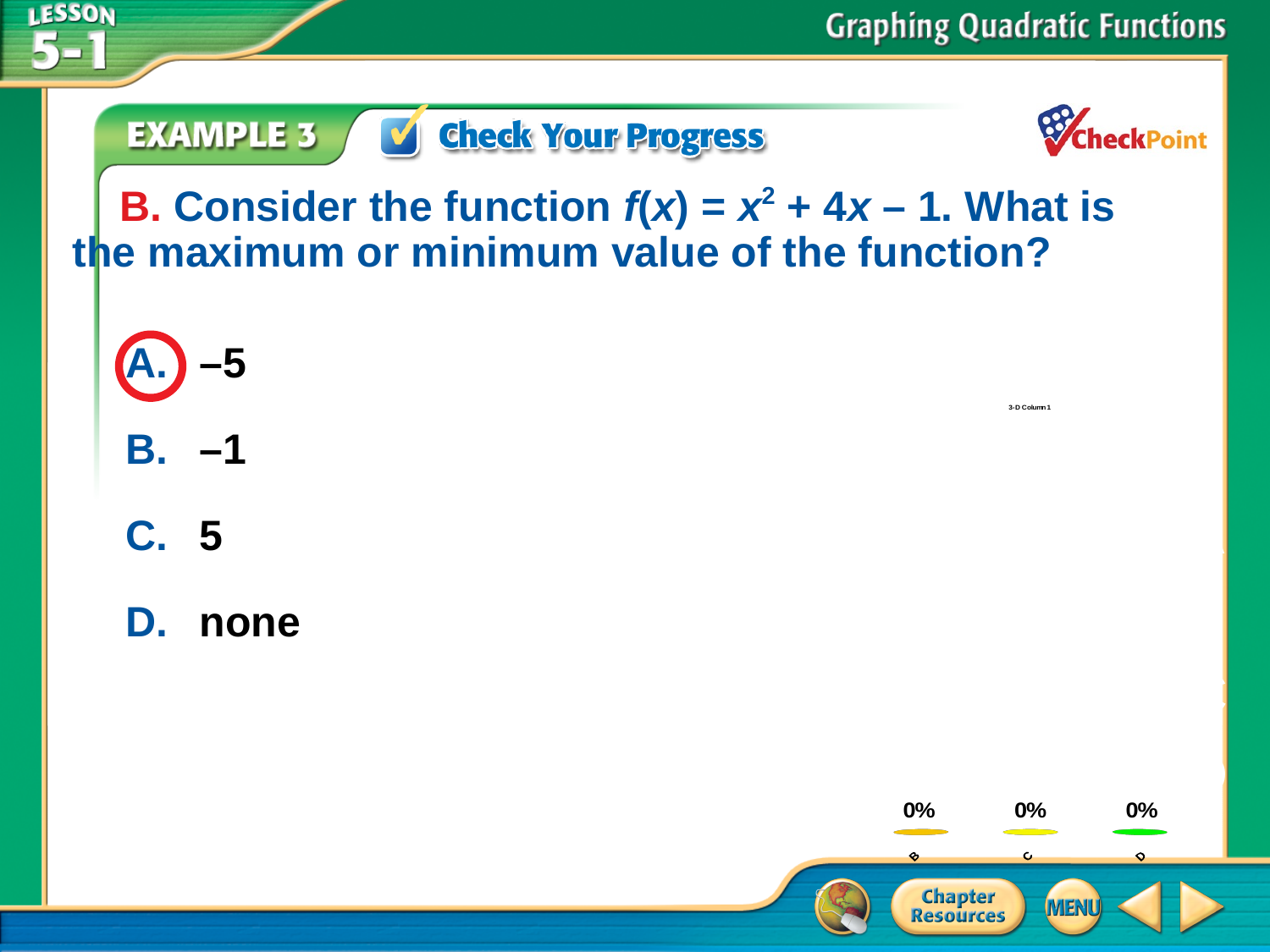
What is the value shown for category B in the chart at the bottom right of the slide? 0% What is the value shown for category C in the chart at the bottom right of the slide? 0% What is the value shown for category D in the chart at the bottom right of the slide? 0% What kind of chart is shown at the bottom right of the slide? bar chart